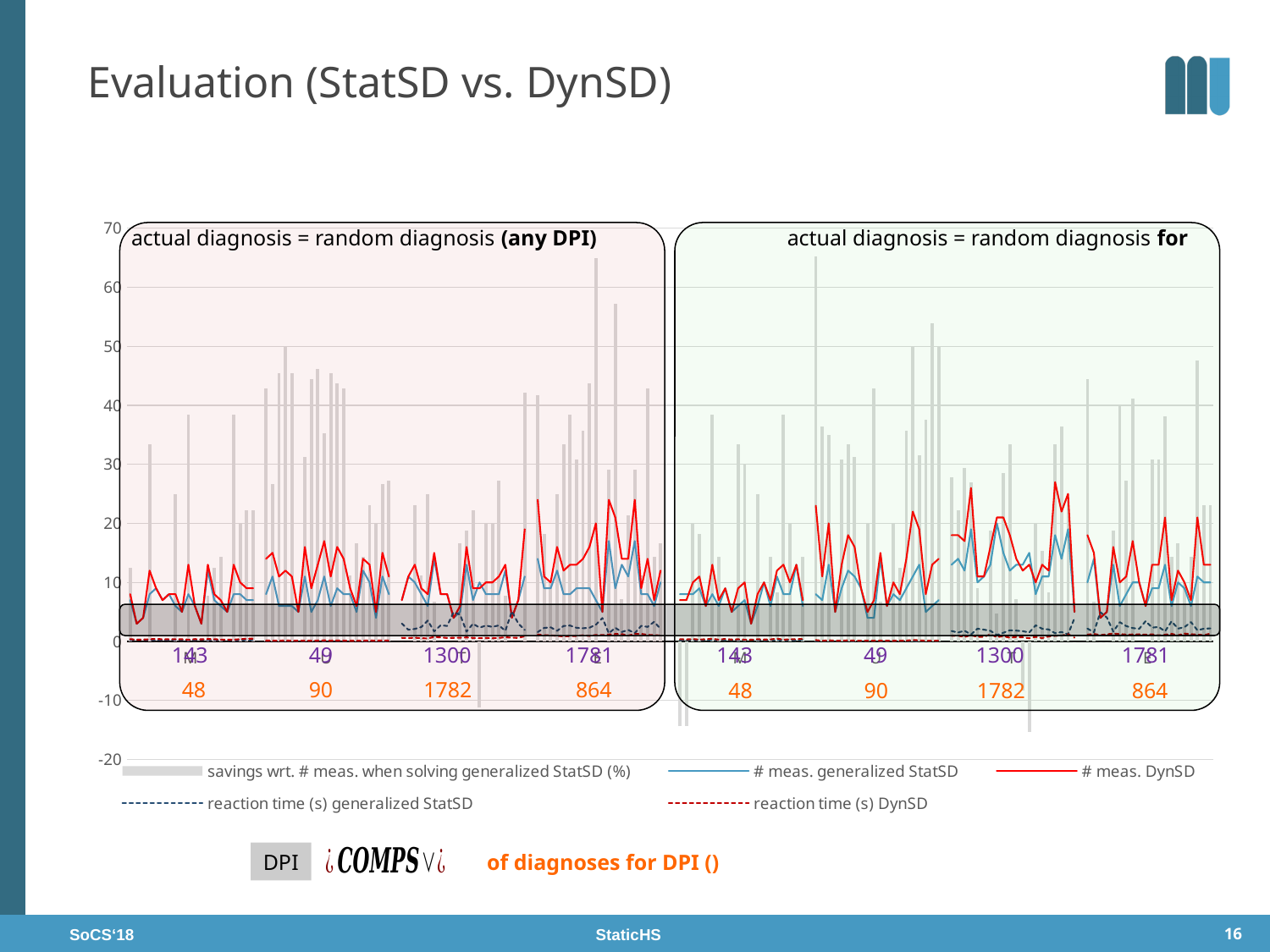
What is the highest value shown on the vertical axis? 70 Is the maximum value of the # meas. DynSD line greater or less than 30? less Is the tallest savings bar in the right panel greater or less than 60? greater Does the chart use bars, lines, or both? both What colour is the line for # meas. DynSD? red How many series does the legend list? 5 How many panels (shaded regions) is the chart divided into? 2 Is the tallest savings bar in the left panel greater or less than 60? greater Which series generally has higher values, # meas. DynSD or # meas. generalized StatSD? # meas. DynSD Which series is drawn as grey bars? savings wrt. # meas. when solving generalized StatSD (%) What is the lowest value shown on the vertical axis? -20